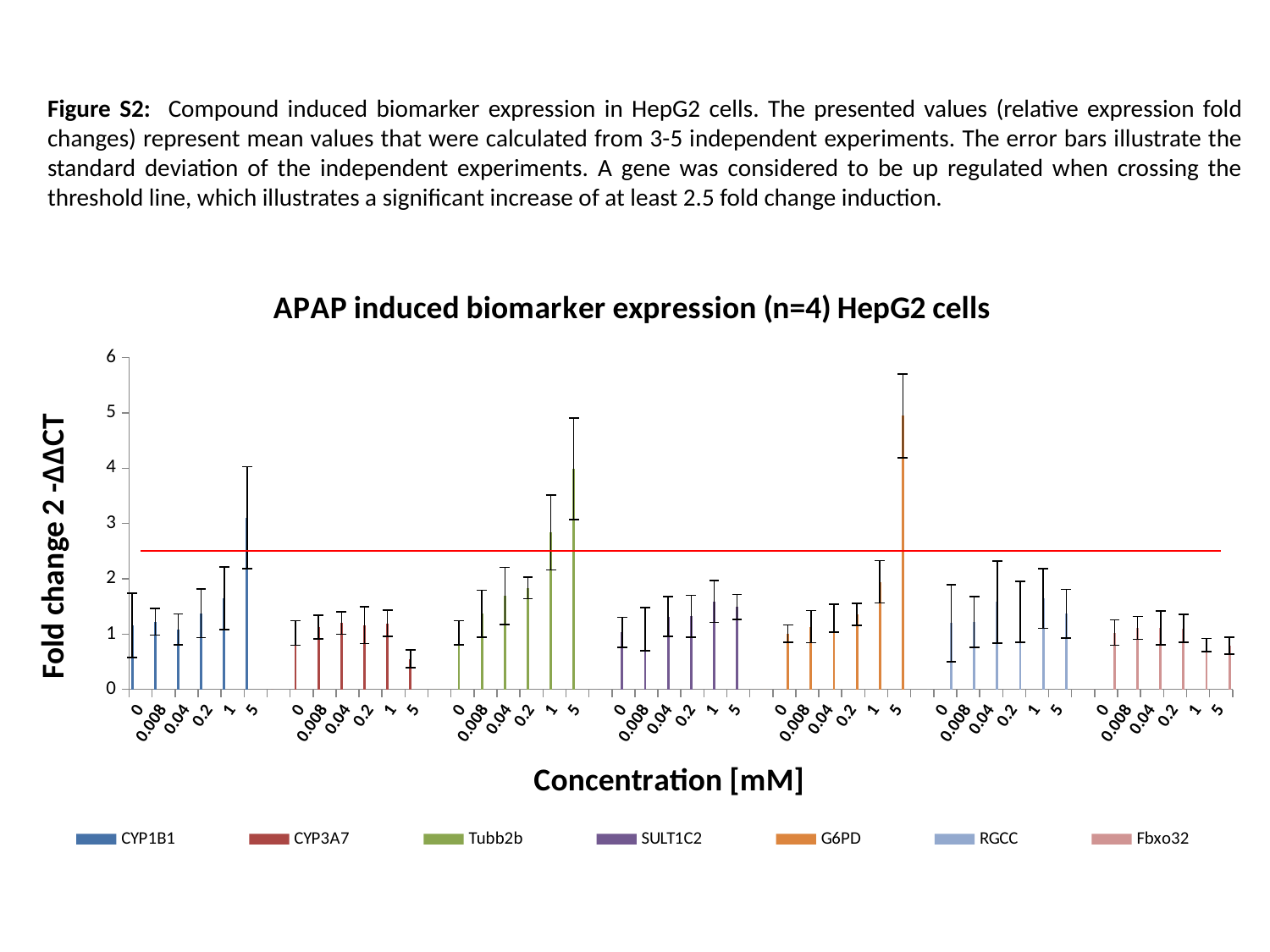
What is the title of the chart? APAP induced biomarker expression (n=4) HepG2 cells Within the CYP3A7 series, which concentration has the lowest fold change? 5 Is the value for Fbxo32 at 5 mM greater or less than 1? less What is the label of the x axis? Concentration [mM] How many concentration levels are plotted for each gene? 6 Is the value for G6PD at 5 mM greater or less than 3? greater Within the G6PD series, which concentration has the highest fold change? 5 How many series does the legend list? 7 Is the value for CYP1B1 at 5 mM greater or less than 2? greater For CYP1B1, which is larger: the value at 0 mM or the value at 5 mM? 5 mM What kind of chart is shown on the slide? bar chart